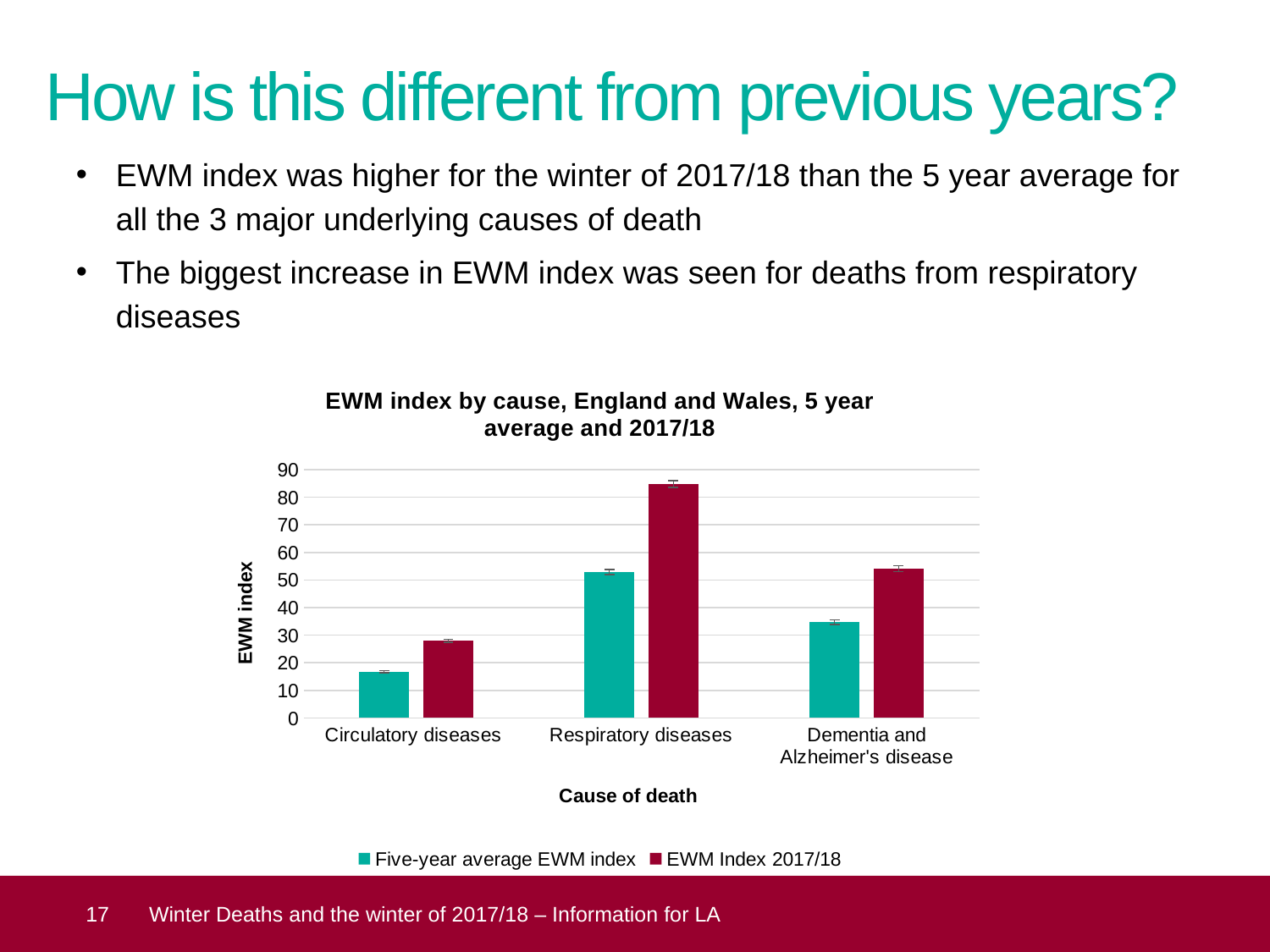
For Dementia and Alzheimer's disease, which is larger: the Five-year average EWM index or the EWM Index 2017/18? EWM Index 2017/18 Is the EWM Index 2017/18 for Dementia and Alzheimer's disease greater or less than 50? greater Is the Five-year average EWM index for Circulatory diseases greater or less than 20? less Which cause of death has the highest Five-year average EWM index? Respiratory diseases Which cause of death has the highest EWM Index 2017/18? Respiratory diseases What is the title of the chart? EWM index by cause, England and Wales, 5 year average and 2017/18 What is the label on the vertical axis of the chart? EWM index How many series does the chart legend list? 2 What kind of chart is shown on the slide? Bar chart How many causes of death are shown on the x axis of the chart? 3 Which cause of death has the lowest Five-year average EWM index? Circulatory diseases Is the EWM Index 2017/18 for Respiratory diseases greater or less than 80? greater